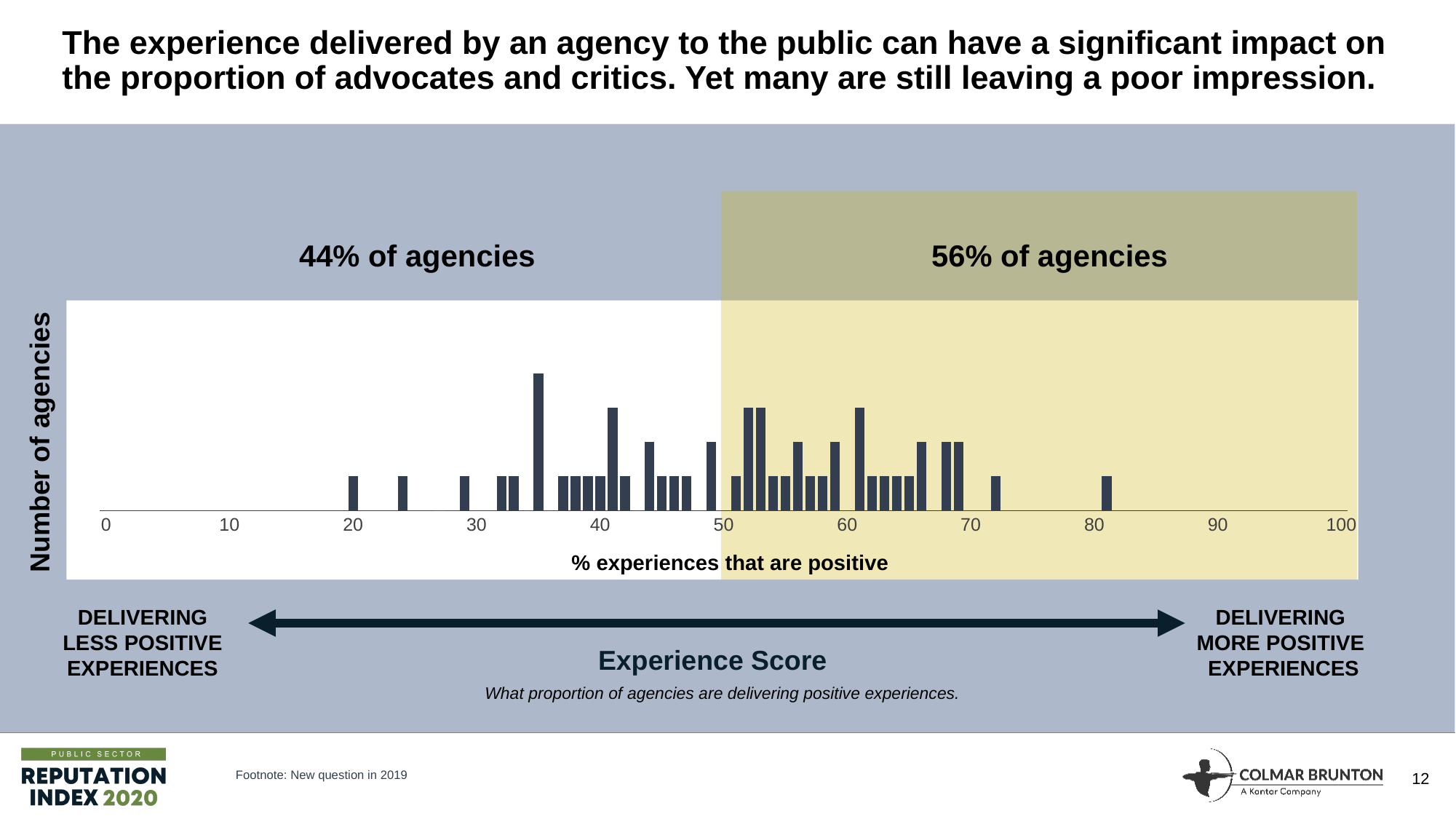
What does the vertical axis of the chart represent? Number of agencies What kind of chart is shown on the slide? Bar chart Which group is larger: agencies scoring below 50 or agencies scoring 50 and above? Agencies scoring 50 and above (56%) Is the rightmost bar on the chart located at an experience score greater or less than 70? greater What is the difference in percentage points between the share of agencies scoring 50 and above and the share scoring below 50? 12 percentage points What is the title of the chart's x axis? % experiences that are positive What proportion of agencies fall in the shaded region of the chart (experience score of 50 or above)? 56% of agencies Is the share of agencies scoring 50 or above greater or less than 50%? greater Is the tallest bar on the chart located at an experience score greater or less than 50? less How many tick labels are shown on the x axis of the chart? 11 What is the lowest experience score at which any agency appears on the chart? 20 What proportion of agencies have an experience score below 50, according to the annotation on the chart? 44% of agencies